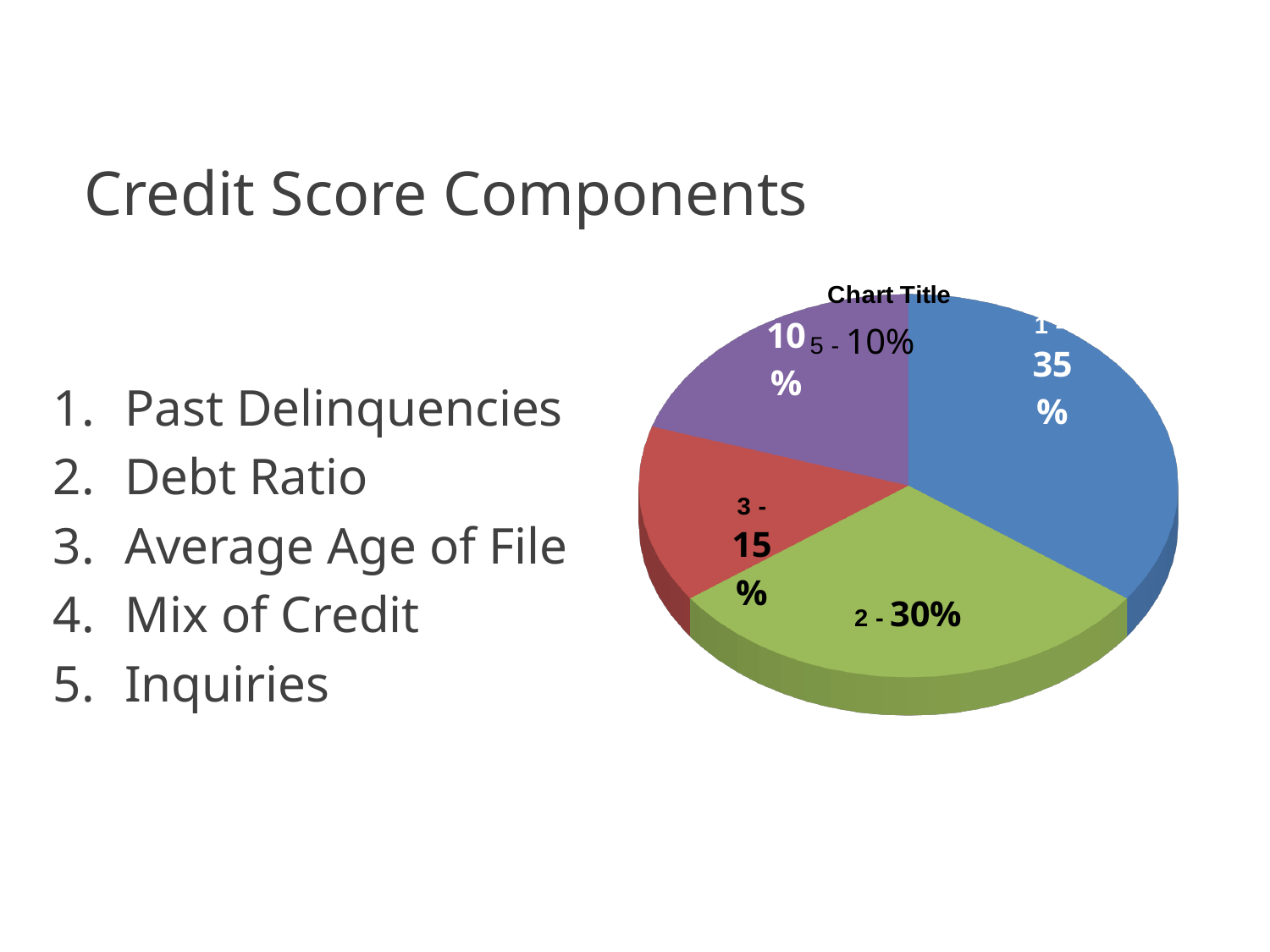
What percentage does slice 3 of the pie chart represent? 15% What is the difference in percentage points between slice 1 and slice 2? 5 What colour is the largest slice of the pie chart? blue What kind of chart is shown on the slide? pie chart Which slice of the pie chart is the largest? 1 What percentage does slice 2 of the pie chart represent? 30% What is the title shown on the chart? Chart Title What share of the pie does slice 3 take? 15% What is the difference in percentage points between slice 2 and slice 3? 15 What percentage does slice 1 of the pie chart represent? 35% Which is larger, slice 2 or slice 3? slice 2 What percentage does slice 5 of the pie chart represent? 10%